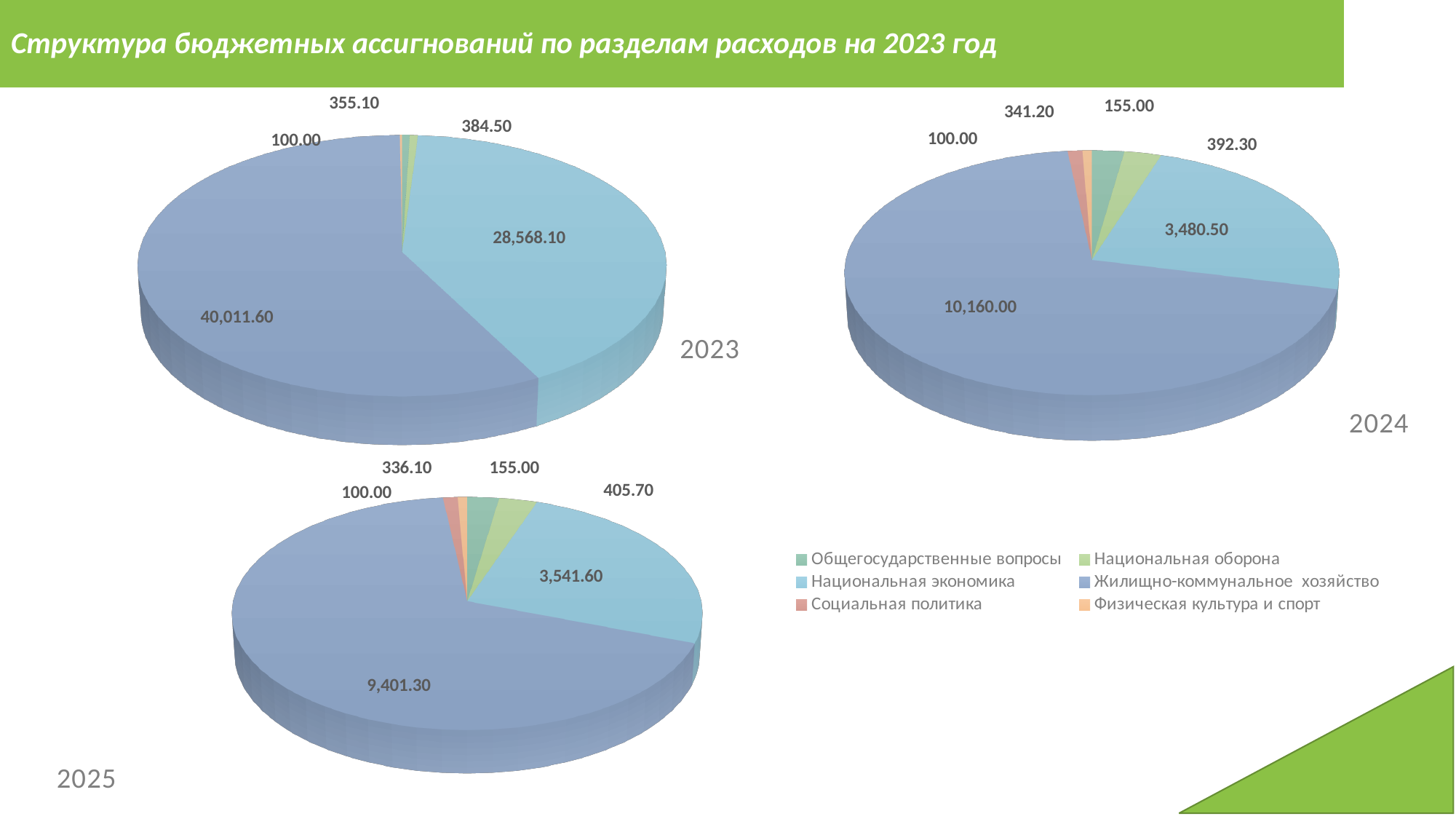
In the 2025 pie chart, what is the value for Национальная экономика? 3,541.60 In the 2024 pie chart, what is the value for Жилищно-коммунальное хозяйство? 10,160.00 In the 2023 pie chart, what is the value for Жилищно-коммунальное хозяйство? 40,011.60 In the 2023 pie chart, what is the difference between Жилищно-коммунальное хозяйство and Национальная экономика? 11,443.50 In the 2025 pie chart, which category has the largest slice? Жилищно-коммунальное хозяйство How many categories does the legend list? 6 What kind of charts are shown on the slide? Pie charts In the 2024 pie chart, what is the smallest labeled value? 100.00 In the 2024 pie chart, what is the difference between Жилищно-коммунальное хозяйство and Национальная экономика? 6,679.50 Which is larger: Жилищно-коммунальное хозяйство in the 2024 chart or in the 2025 chart? 2024 In the 2023 pie chart, what is the value for Национальная экономика? 28,568.10 How many pie charts are on the slide? 3